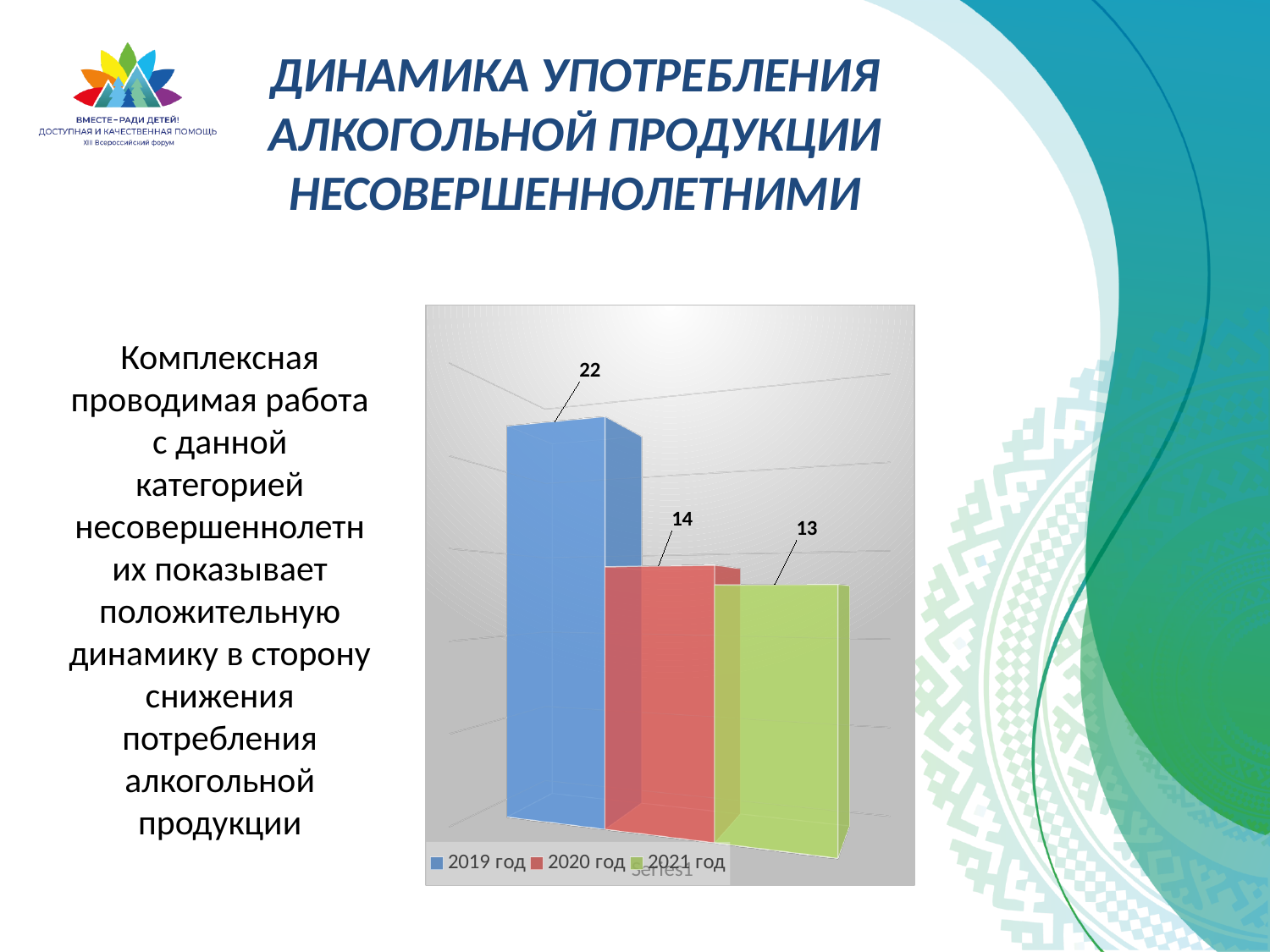
What is the difference between the values for 2019 год and 2020 год? 8 What is the value for 2019 год? 22 How many series does the legend list? 3 What is the difference between the values for 2020 год and 2021 год? 1 What is the value for 2021 год? 13 What colour is the bar for 2020 год? red Which year has the lowest value? 2021 год What kind of chart is shown on the slide? bar chart Which is larger, the value for 2019 год or the value for 2021 год? 2019 год What is the value for 2020 год? 14 Do the values rise or fall from 2019 год to 2021 год? fall Which year has the highest value? 2019 год